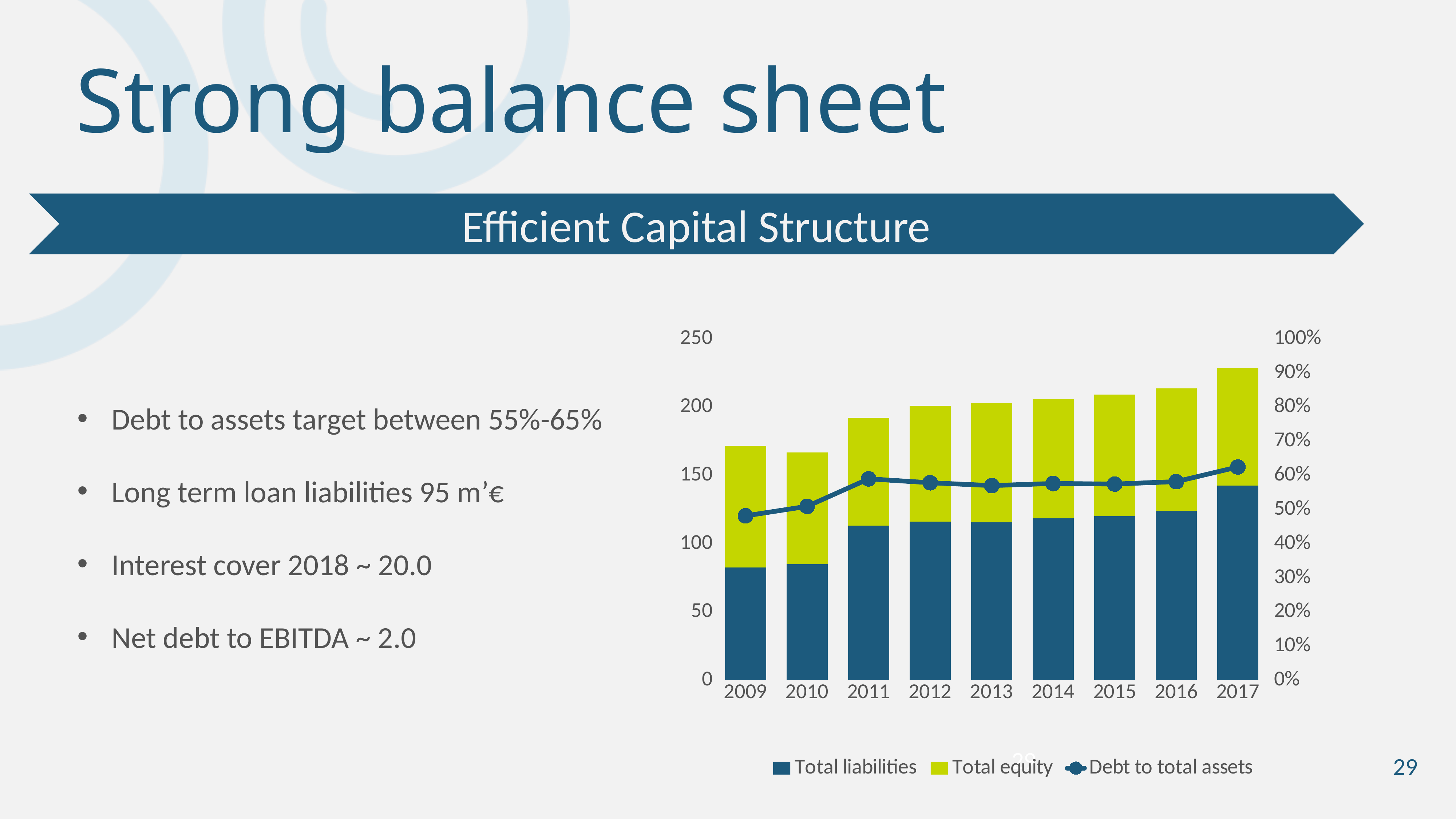
Which year has the tallest stacked bar (Total liabilities plus Total equity)? 2017 How many years are shown on the x axis of the chart? 9 Is the Total liabilities value for 2017 greater or less than 100? greater Is the total stacked bar for 2009 greater or less than 200? less Which series is shown in green in the chart? Total equity In which year is the Debt to total assets line at its highest? 2017 Is the total stacked bar for 2017 greater or less than 200? greater How many series does the chart legend list? 3 What kind of chart is shown on the slide? Stacked bar chart with a line Does the Debt to total assets line generally rise or fall from 2009 to 2017? rise